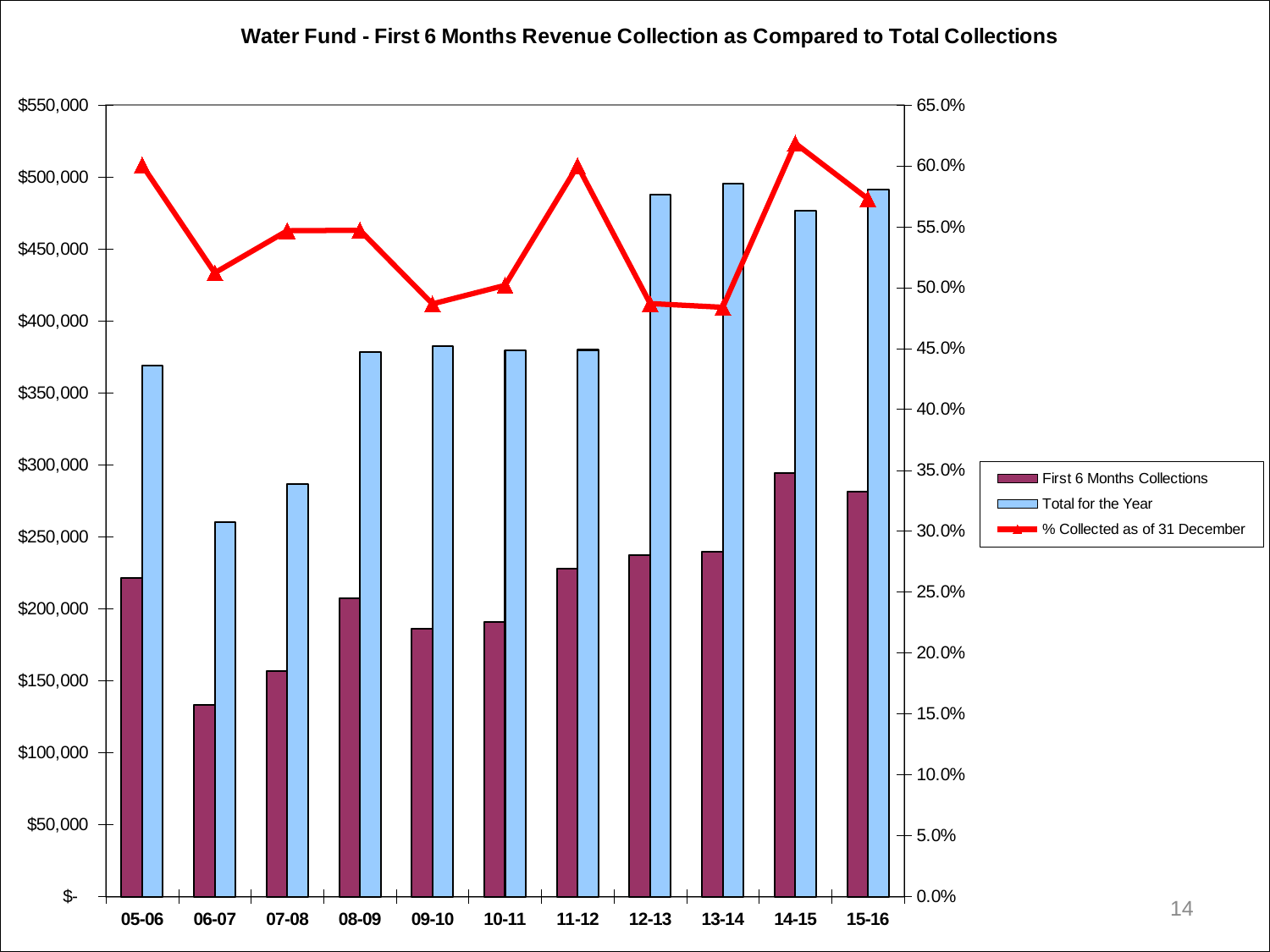
Which fiscal year has the highest % Collected as of 31 December? 14-15 What kind of chart is shown on the slide? A combined bar and line chart Which is larger, the Total for the Year in 05-06 or in 07-08? 05-06 How many fiscal years are shown on the x axis? 11 How many series does the legend list? 3 Which fiscal year has the highest First 6 Months Collections? 14-15 Is the % Collected as of 31 December for 05-06 greater or less than 55.0%? greater Which fiscal year has the lowest Total for the Year? 06-07 Which fiscal year has the lowest First 6 Months Collections? 06-07 Is the First 6 Months Collections value for 06-07 greater or less than $150,000? less Is the Total for the Year in 12-13 greater or less than $450,000? greater What is the title of the chart? Water Fund - First 6 Months Revenue Collection as Compared to Total Collections